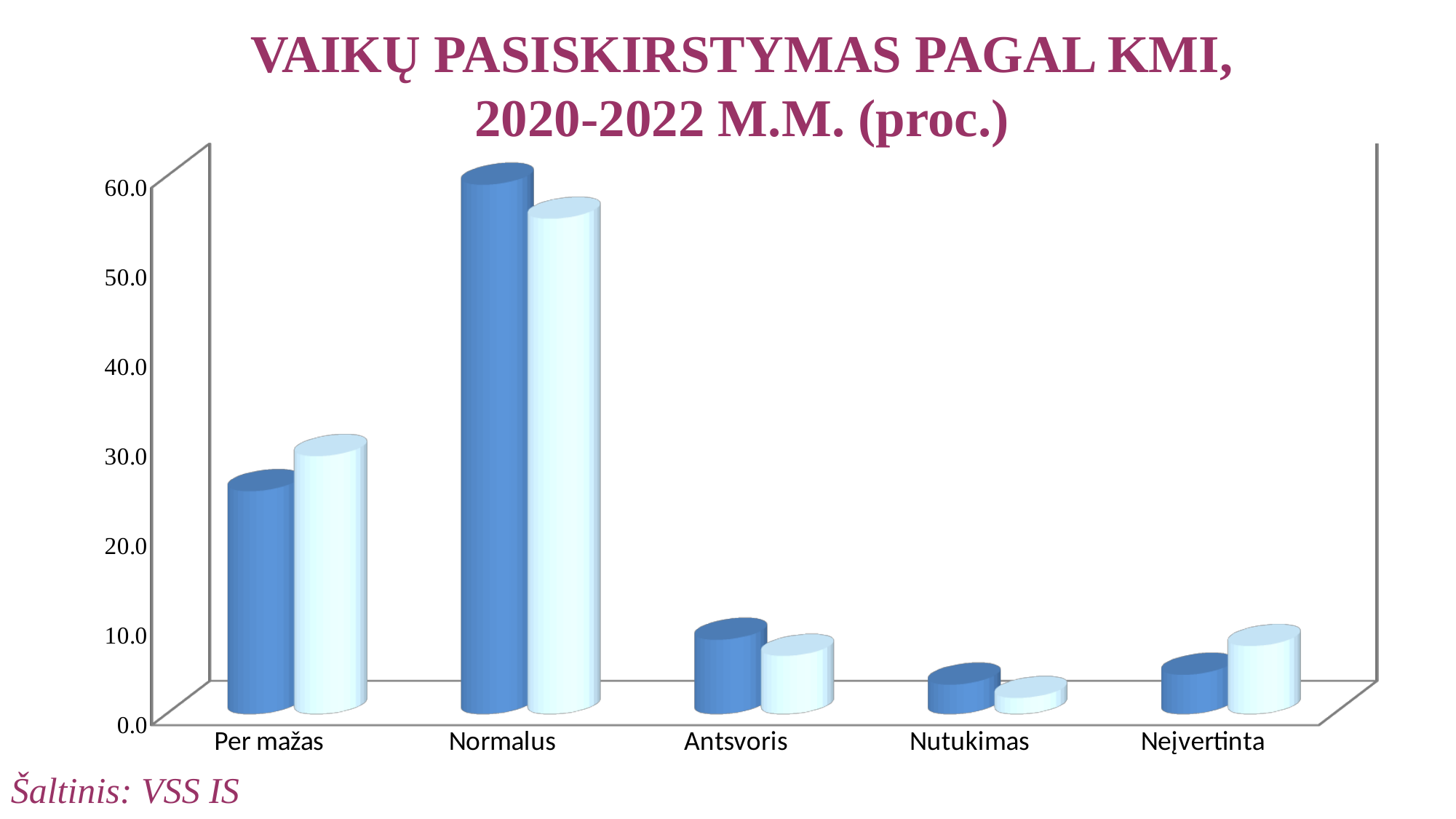
Which category has the highest dark blue bar? Normalus For Antsvoris, which bar is taller, the dark blue or the light blue one? dark blue Which category has the lowest light blue bar? Nutukimas How many categories are shown on the x axis? 5 Is the dark blue value for Normalus greater or less than 50.0? greater For Per mažas, which bar is taller, the dark blue or the light blue one? light blue How many bars are plotted for each category? 2 Is the light blue value for Neįvertinta greater or less than 10.0? less What is the title of the chart? VAIKŲ PASISKIRSTYMAS PAGAL KMI, 2020-2022 M.M. (proc.) What kind of chart is shown on the slide? bar chart Is the dark blue value for Per mažas greater or less than 30.0? less Do the dark blue values rise or fall from Normalus to Nutukimas? fall